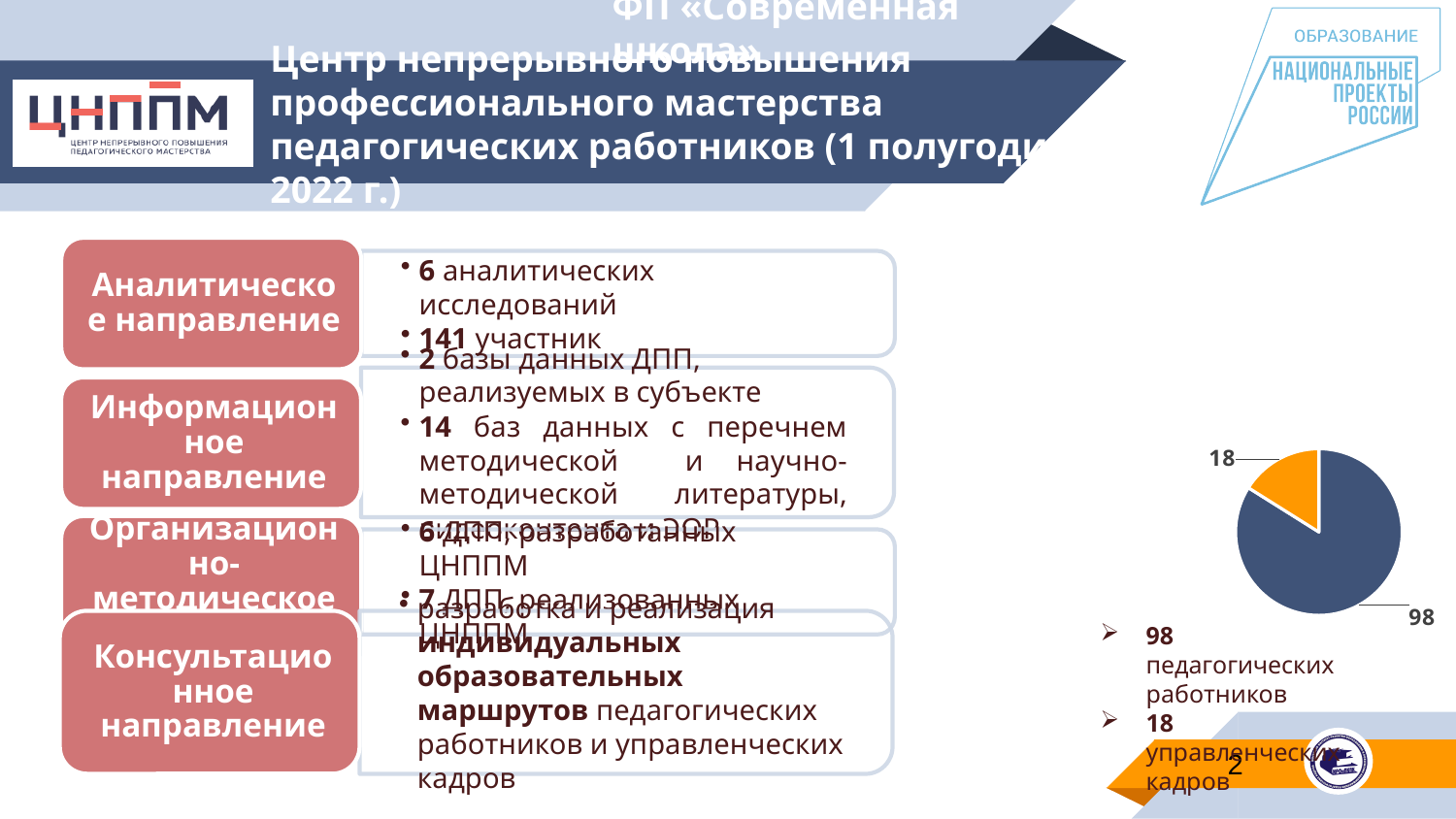
What value is labelled on the smaller slice of the pie chart? 18 Which slice of the pie chart is the smallest? 18 (управленческих кадров) According to the pie chart and the text below it, how many управленческих кадров are shown? 18 According to the pie chart and the text below it, how many педагогических работников are shown? 98 What is the total of the two values shown in the pie chart? 116 What kind of chart is shown on the right side of the slide? pie chart What colour is the slice labelled 98 in the pie chart? dark blue What is the difference between the two values shown in the pie chart? 80 Which group has the larger slice in the pie chart, педагогических работников or управленческих кадров? педагогических работников What value is labelled on the larger slice of the pie chart? 98 How many slices does the pie chart have? 2 What colour is the slice labelled 18 in the pie chart? orange